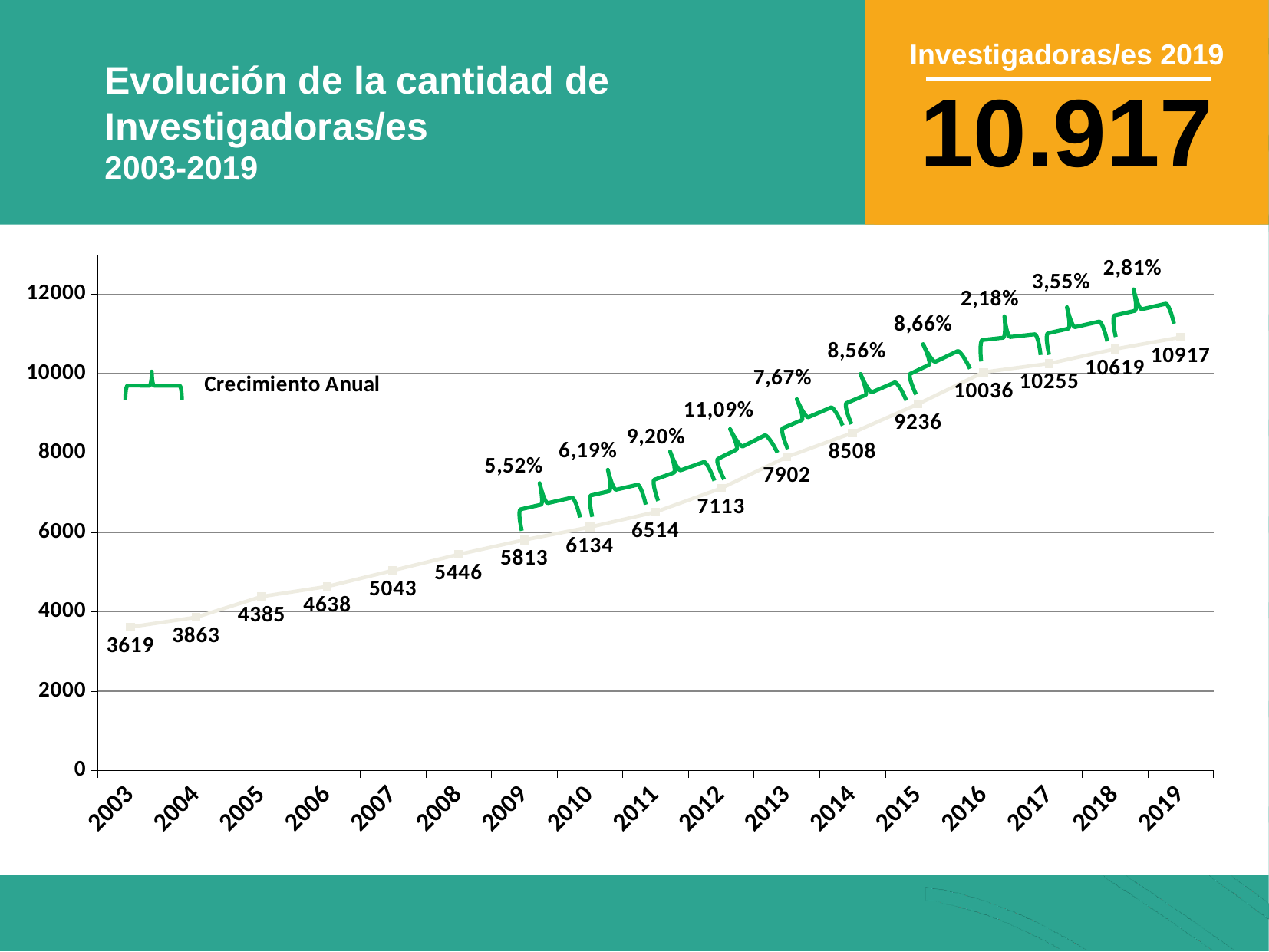
What is the number of researchers shown for 2019? 10917 What is the number of researchers shown for 2003? 3619 Do the number of researchers rise or fall from 2003 to 2019? rise Which year has the highest number of researchers? 2019 Which year has the lowest number of researchers? 2003 What type of chart is shown on the slide? line chart Is the number of researchers in 2014 greater or less than 8000? greater What is the difference between the number of researchers in 2019 and in 2003? 7298 What is the number of researchers shown for 2012? 7113 What is the difference between the number of researchers in 2016 and in 2015? 800 Which year has more researchers, 2010 or 2013? 2013 How many years are plotted on the x axis? 17